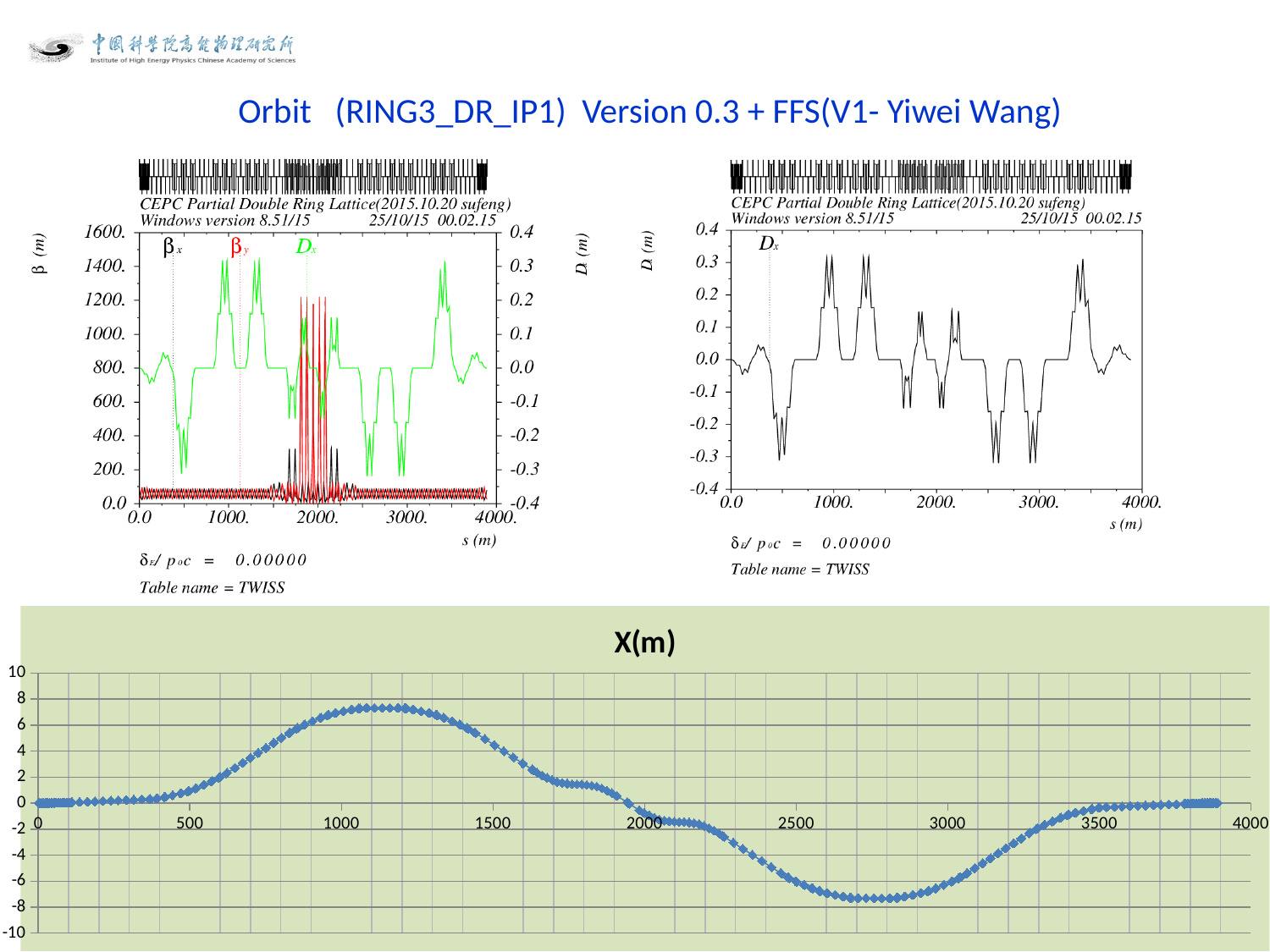
In the bottom chart titled X(m), is the value at s = 2500 greater or less than -4? less In the top-left chart, how many series are labelled in the legend? 3 In the bottom chart titled X(m), is the value at s = 3000 greater or less than 0? less In the bottom chart titled X(m), is the value at s = 2000 greater or less than 0? less What kind of chart is the bottom chart titled X(m)? line chart In the bottom chart titled X(m), does the curve rise or fall between s = 2000 and s = 2500? fall What is the title of the bottom chart? X(m) In the bottom chart titled X(m), does the curve rise or fall between s = 500 and s = 1000? rise In the bottom chart titled X(m), which is larger: the value at s = 1000 or the value at s = 3000? the value at s = 1000